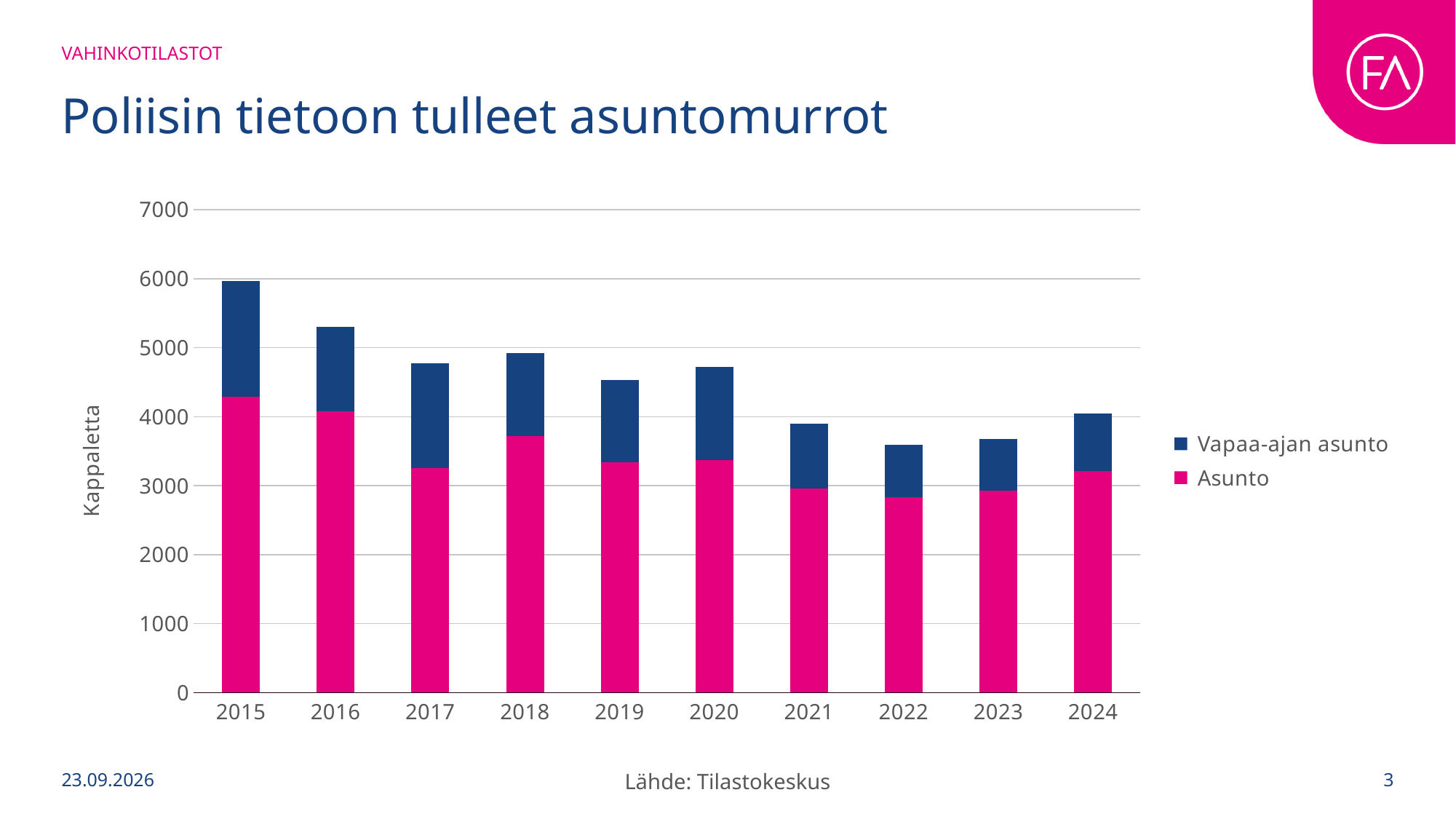
Is the total bar for 2019 greater or less than 5000? less Which year has the highest total bar in the chart? 2015 What are the two series named in the chart's legend? Vapaa-ajan asunto and Asunto Is the total bar for 2015 greater or less than 5000? greater Which year has the larger total bar, 2018 or 2019? 2018 Is the Asunto value for 2015 greater or less than 4000? greater What kind of chart is shown on the slide? Stacked bar chart How many years are shown on the x axis of the chart? 10 How many series does the chart's legend list? 2 Do the total bars generally rise or fall from 2015 to 2022? fall